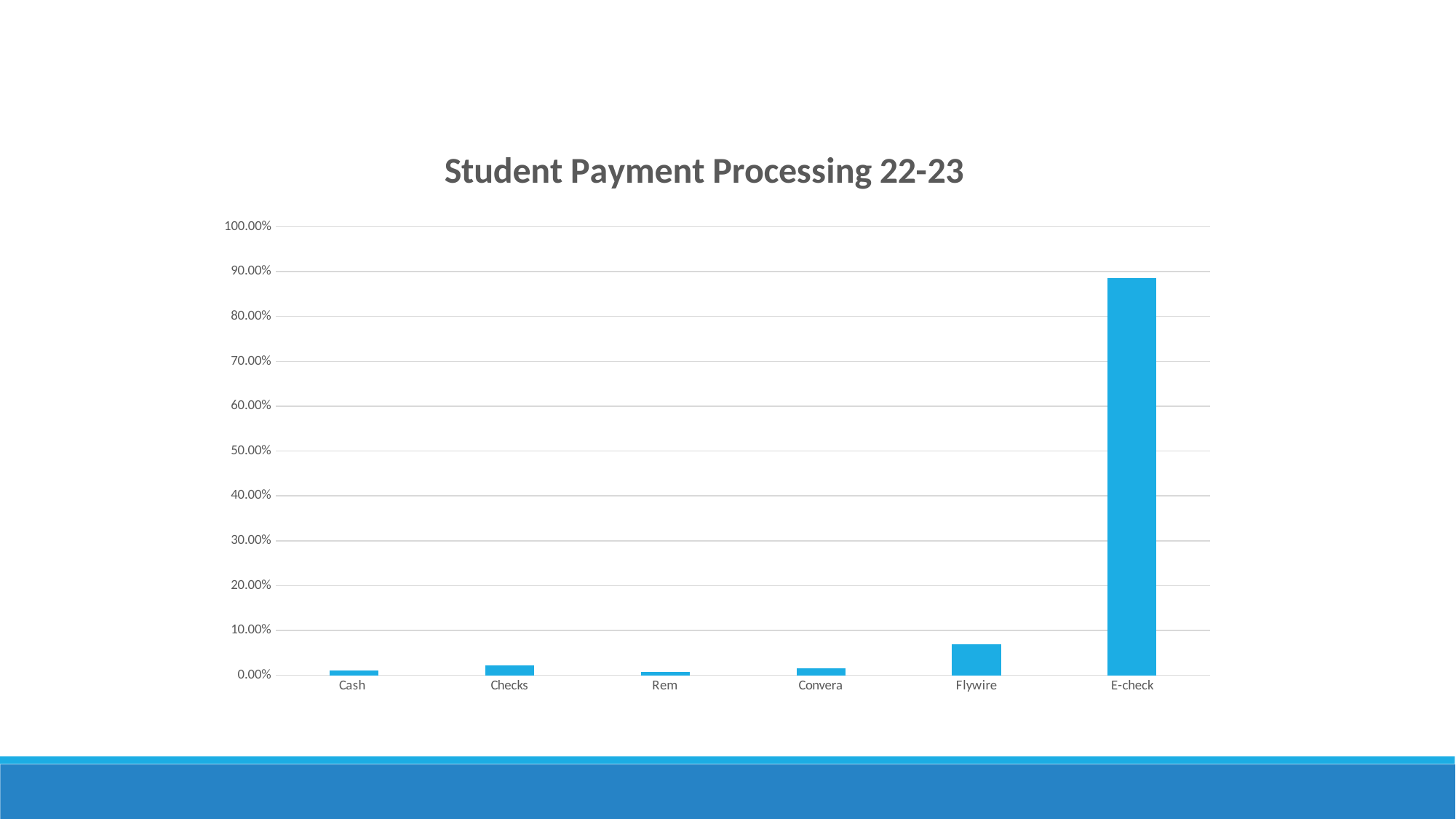
What type of chart is shown on the slide? bar chart Is the value for E-check greater or less than 50.00%? greater Which category has the highest value? E-check Which is larger, the value for Flywire or the value for Convera? Flywire Which is larger, the value for Flywire or the value for Cash? Flywire What is the title of the chart? Student Payment Processing 22-23 Is the value for Checks greater or less than 10.00%? less What is the highest value shown on the y axis? 100.00% Is the value for Flywire greater or less than 10.00%? less Which is larger, the value for E-check or the value for Flywire? E-check How many payment categories are shown on the x axis? 6